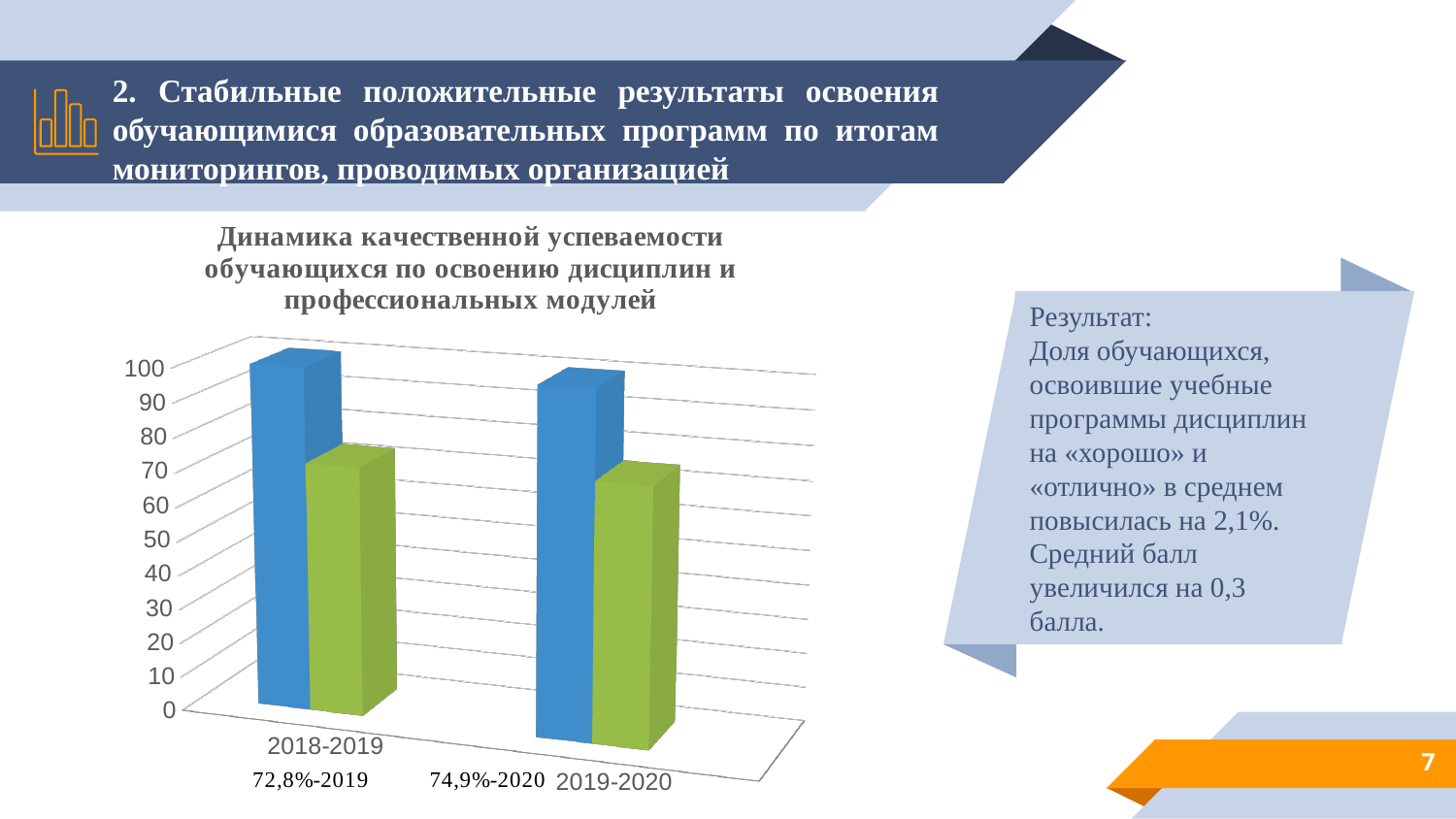
Is the value of the green bar for 2018-2019 greater or less than 50? greater How many categories are shown on the x axis of the chart? 2 For 2019-2020, which bar is taller, the blue one or the green one? the blue one For 2018-2019, which bar is taller, the blue one or the green one? the blue one What is the title of the chart? Динамика качественной успеваемости обучающихся по освоению дисциплин и профессиональных модулей Is the value of the blue bar for 2018-2019 greater or less than 90? greater What is the highest tick value shown on the vertical axis of the chart? 100 How many bars are plotted in the chart in total? 4 What kind of chart is shown on the slide? bar chart Is the value of the green bar for 2019-2020 greater or less than 40? greater What are the two category labels on the x axis of the chart? 2018-2019 and 2019-2020